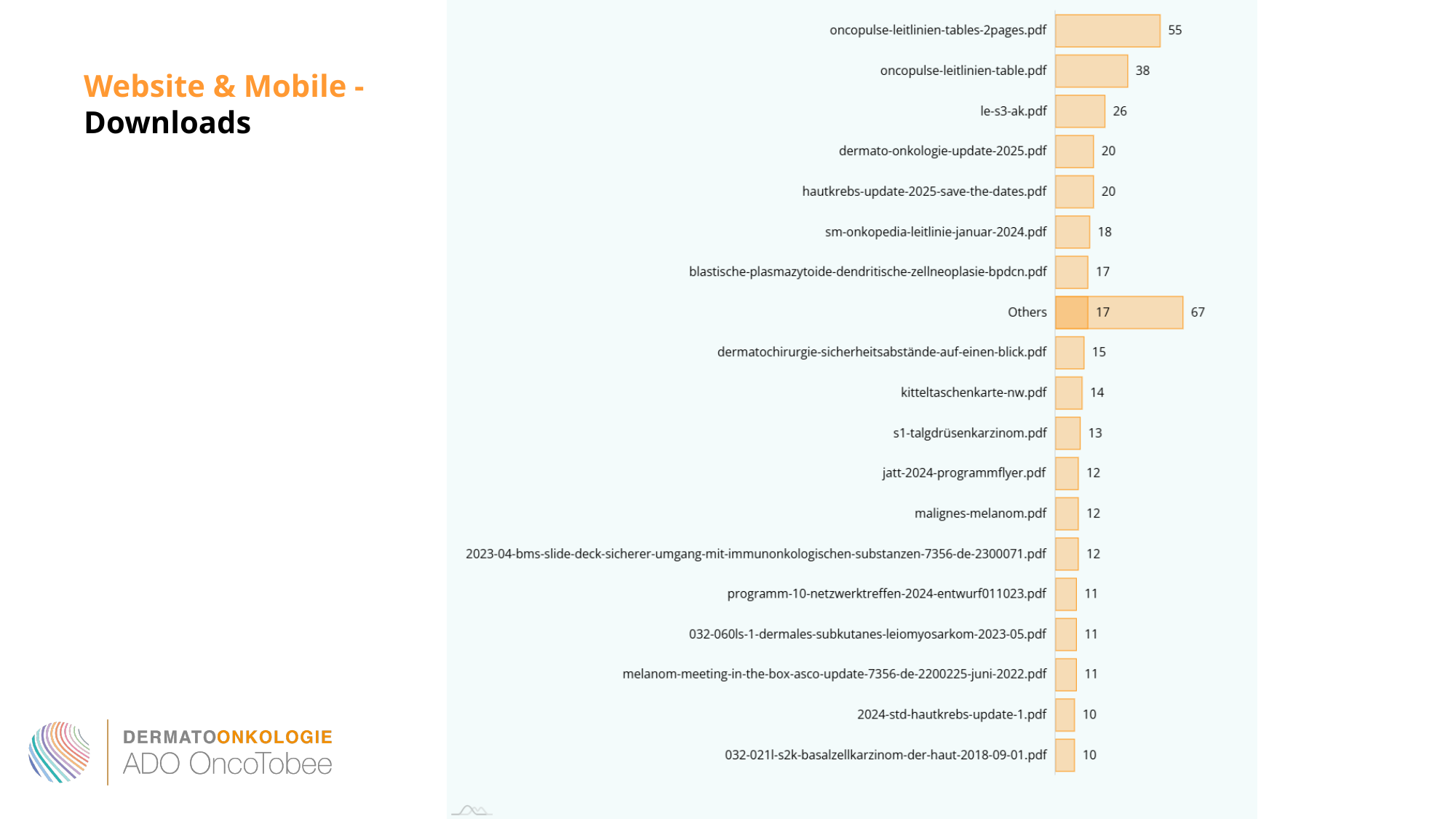
How many categories (rows) are shown in the chart? 19 Which has a larger value, le-s3-ak.pdf or dermato-onkologie-update-2025.pdf? le-s3-ak.pdf What is the title of the slide containing the chart? Website & Mobile - Downloads How many downloads are shown for oncopulse-leitlinien-tables-2pages.pdf? 55 What is the value for sm-onkopedia-leitlinie-januar-2024.pdf? 18 What is the difference between the values for oncopulse-leitlinien-tables-2pages.pdf and oncopulse-leitlinien-table.pdf? 17 What is the value for oncopulse-leitlinien-table.pdf? 38 What is the value for kitteltaschenkarte-nw.pdf? 14 What is the value for 2024-std-hautkrebs-update-1.pdf? 10 What kind of chart is shown on the slide? bar chart What is the value for le-s3-ak.pdf? 26 Which has a larger value, s1-talgdrüsenkarzinom.pdf or malignes-melanom.pdf? s1-talgdrüsenkarzinom.pdf